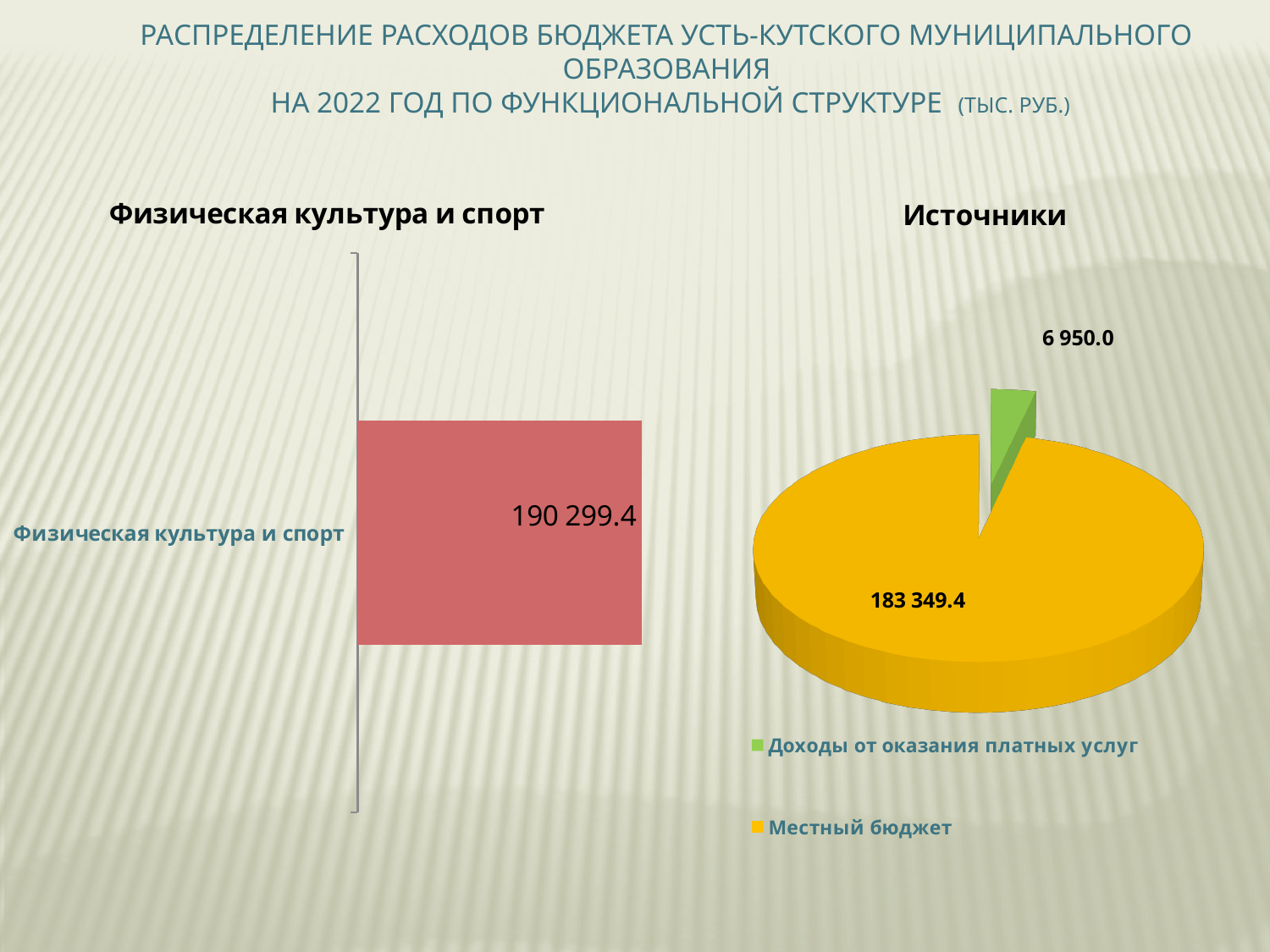
In the 'Источники' pie chart, which slice is the largest? Местный бюджет In the 'Источники' pie chart, what is the value for 'Доходы от оказания платных услуг'? 6 950.0 In the 'Источники' pie chart, which slice is the smallest? Доходы от оказания платных услуг In the 'Источники' pie chart, what is the value for 'Местный бюджет'? 183 349.4 In the 'Источники' pie chart, what is the difference between 'Местный бюджет' and 'Доходы от оказания платных услуг'? 176 399.4 In the 'Источники' pie chart, what colour is the 'Местный бюджет' slice? yellow In the chart titled 'Физическая культура и спорт', what is the value of the bar? 190 299.4 What kind of chart is the chart titled 'Источники' on the right? pie chart How many bars are in the chart titled 'Физическая культура и спорт'? 1 In the 'Источники' pie chart, what is the total of the two slices? 190 299.4 What kind of chart is the chart titled 'Физическая культура и спорт' on the left? bar chart How many entries does the legend of the 'Источники' pie chart list? 2